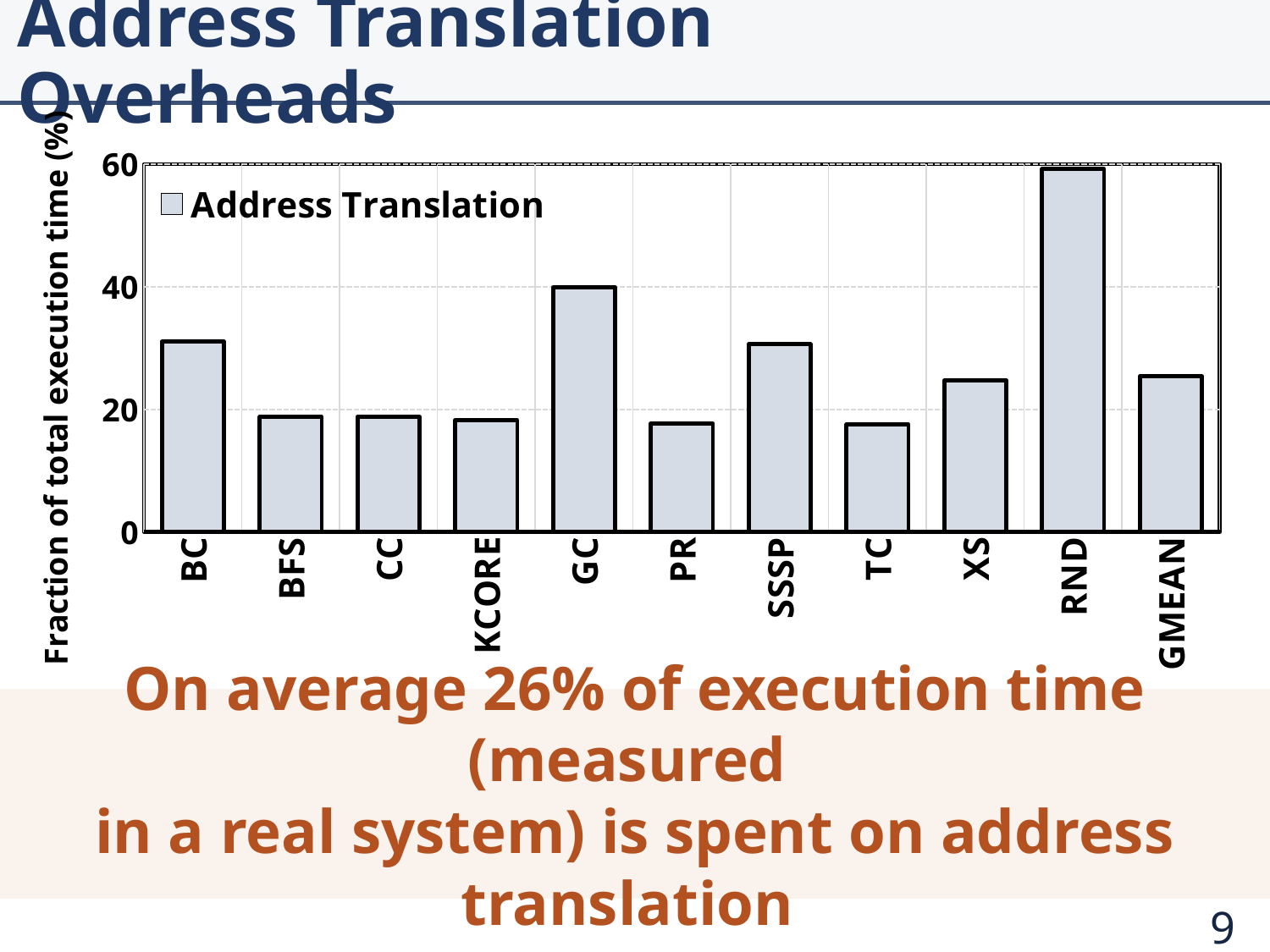
What is the name of the series shown in the chart's legend? Address Translation What is the label of the y axis? Fraction of total execution time (%) Which category has the highest fraction of total execution time? RND How many series does the chart's legend list? 1 Is the value for RND greater or less than 40? greater Which has a larger value, XS or TC? XS Is the value for BC greater or less than 20? greater Is the value for PR greater or less than 20? less What kind of chart is shown on the slide? bar chart How many categories are shown on the x axis of the chart? 11 Which has a larger value, GC or SSSP? GC